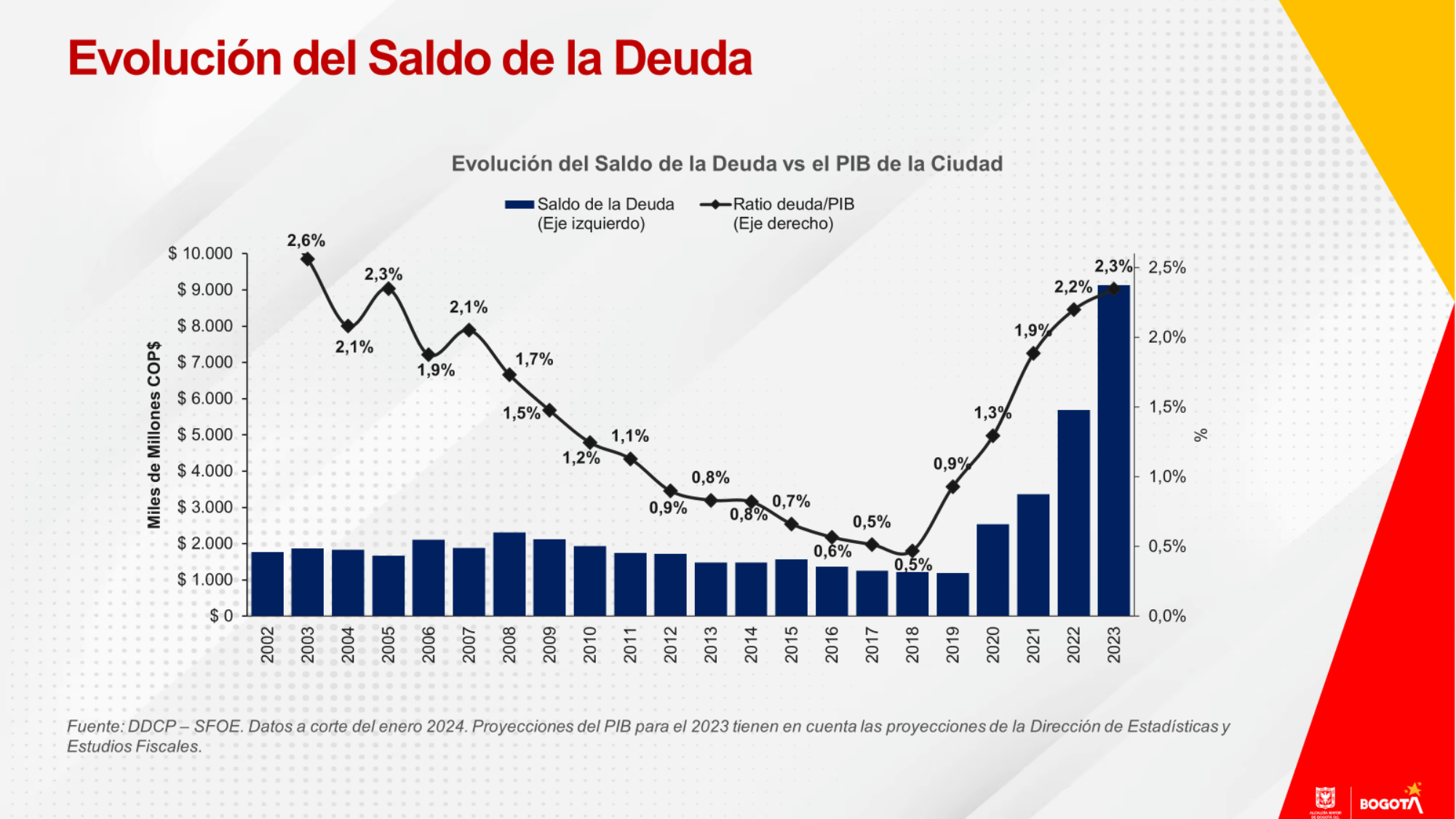
What is the Ratio deuda/PIB value for 2003? 2,6% In which year is the Ratio deuda/PIB highest? 2003 What is the Ratio deuda/PIB value for 2016? 0,6% Which year has the tallest Saldo de la Deuda bar? 2023 What is the difference between the Ratio deuda/PIB in 2003 and in 2023? 0,3% Does the Ratio deuda/PIB rise or fall from 2018 to 2023? rise What type of chart is shown on the slide? Combined bar and line chart Is the Saldo de la Deuda bar for 2023 greater or less than $ 8.000? greater How many series does the legend list? 2 What is the Ratio deuda/PIB value for 2023? 2,3% Is the Saldo de la Deuda bar for 2019 greater or less than $ 2.000? less Which year has a higher Ratio deuda/PIB, 2005 or 2007? 2005